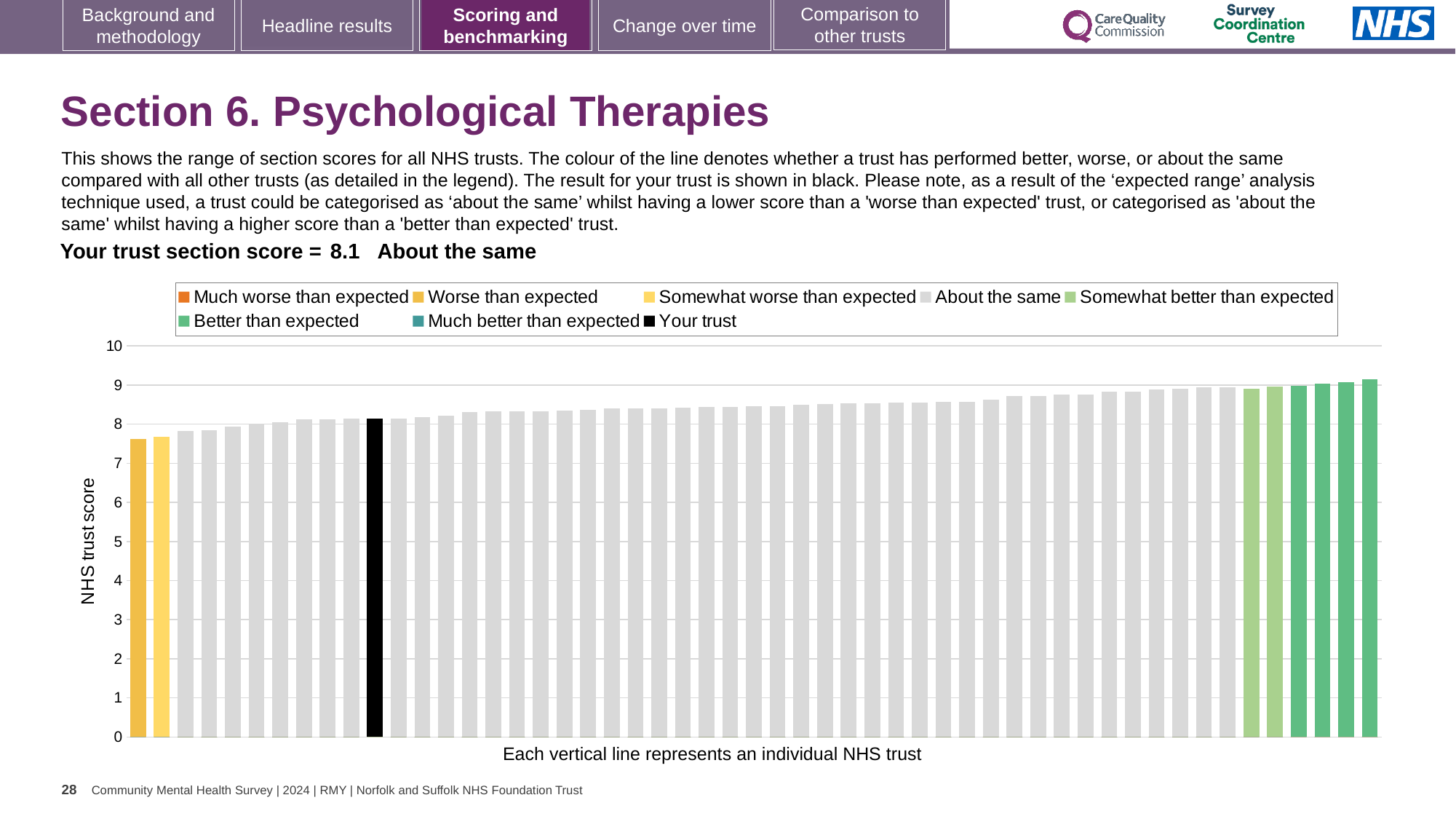
Is the value of the shortest bar greater or less than 7? greater Is the value of the black bar (your trust) greater or less than 9? less Do the bar values rise or fall from left to right along the x axis? rise What colour does the legend use for 'Your trust'? black How many entries does the chart legend list? 8 What is the label on the y axis of the chart? NHS trust score What kind of chart is shown on the slide? bar chart What is the section score for your trust shown on the slide? 8.1 Is the value of the black bar (your trust) greater or less than 8? greater Which is larger, the value of the black bar (your trust) or the value of the rightmost bar? the rightmost bar